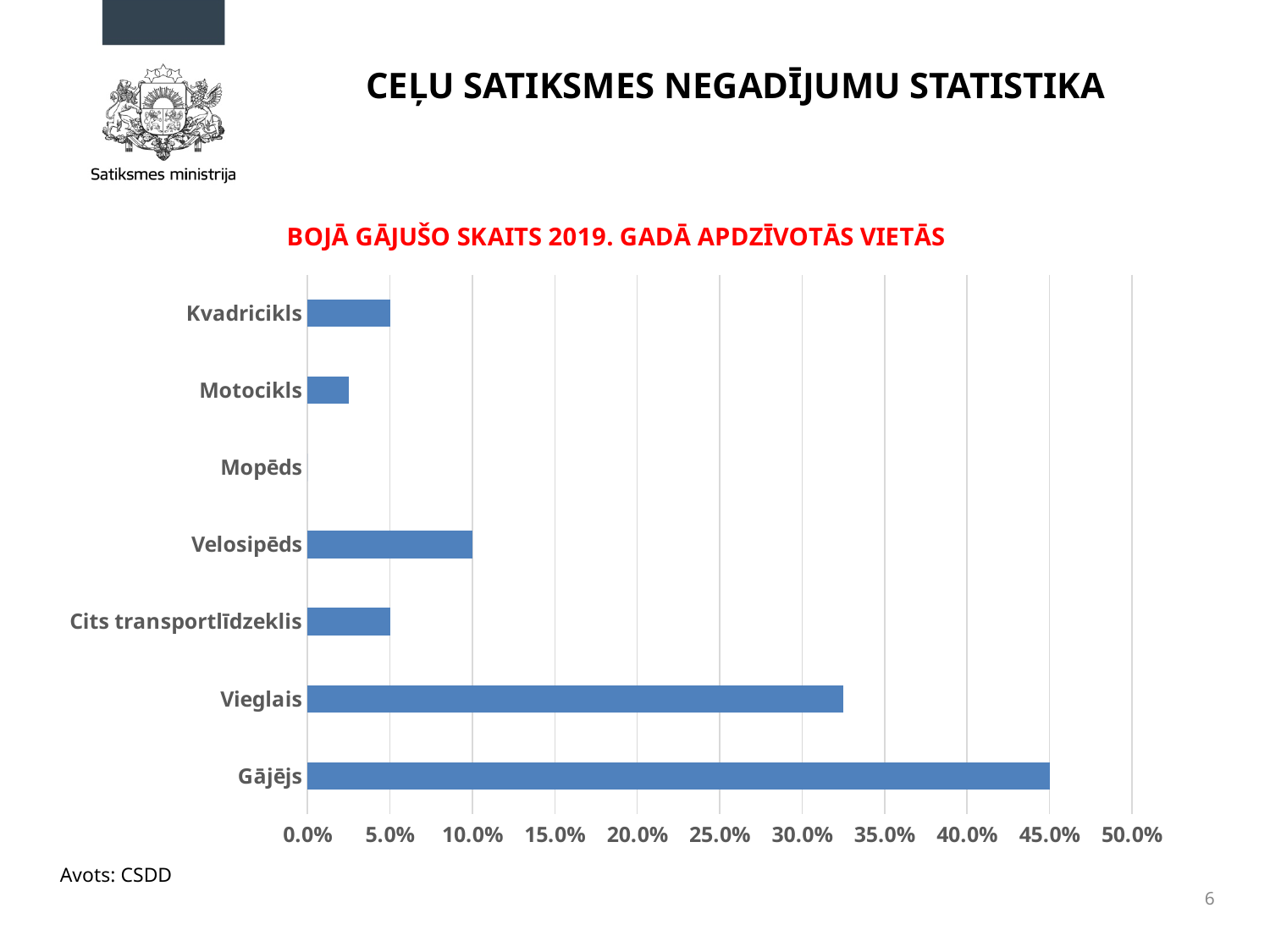
What kind of chart is shown on the slide? bar chart How many categories are shown in the chart? 7 What is the value for Kvadricikls? 5.0% Which is larger, the value for Vieglais or the value for Velosipēds? Vieglais Is the value for Motocikls greater or less than 5.0%? less What is the title of the chart? BOJĀ GĀJUŠO SKAITS 2019. GADĀ APDZĪVOTĀS VIETĀS What is the value for Velosipēds? 10.0% What is the value for Gājējs? 45.0% What is the difference between the values for Gājējs and Velosipēds? 35.0% Which category has the highest value in the chart? Gājējs Which category has the lowest value in the chart? Mopēds Is the value for Vieglais greater or less than 30.0%? greater